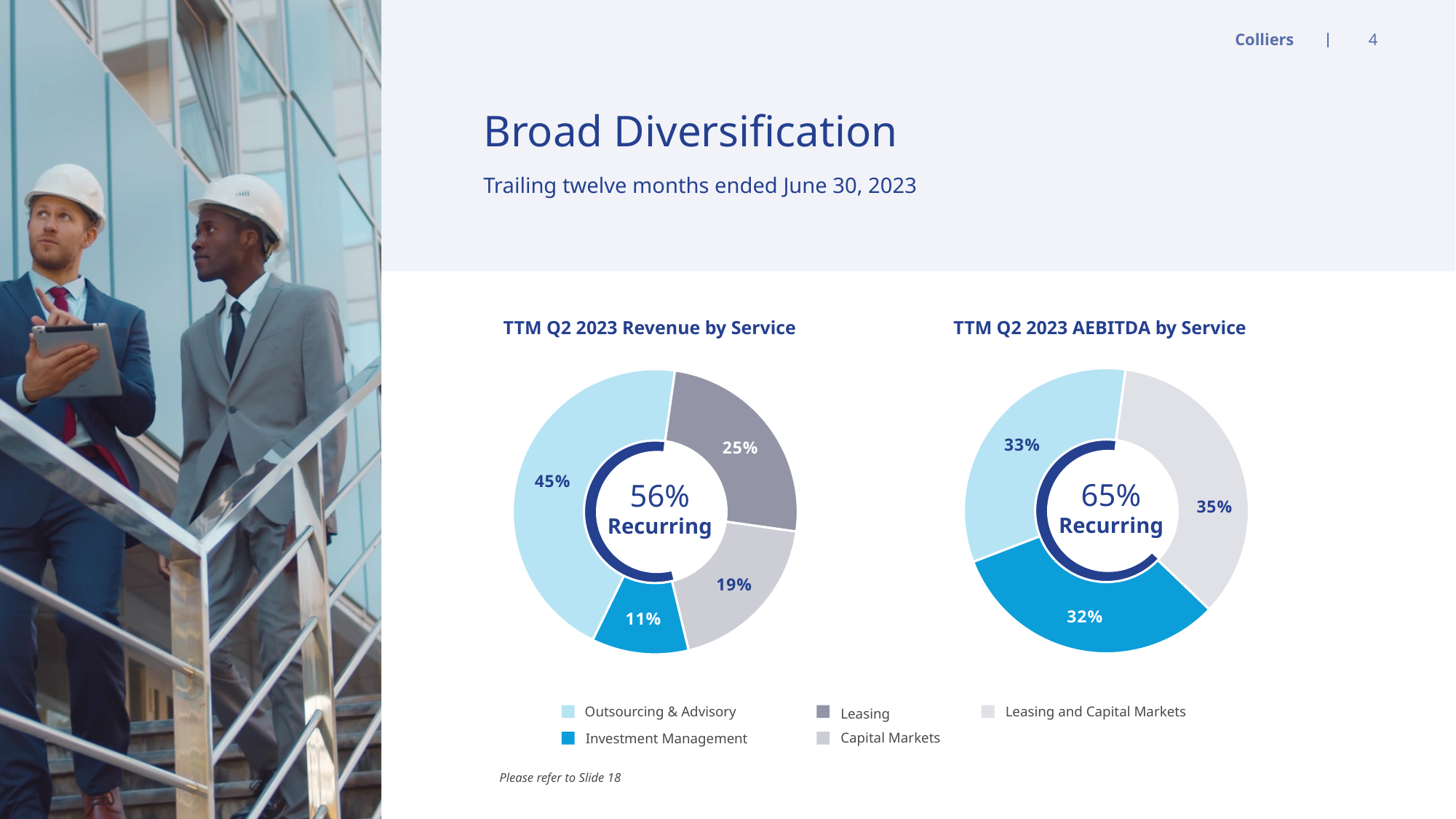
In the TTM Q2 2023 AEBITDA by Service chart, what share comes from Leasing and Capital Markets? 35% What type of chart is the TTM Q2 2023 Revenue by Service chart? Donut (pie) chart In the TTM Q2 2023 Revenue by Service chart, what share of revenue comes from Outsourcing & Advisory? 45% How many segments does the TTM Q2 2023 AEBITDA by Service chart have? 3 In the TTM Q2 2023 Revenue by Service chart, which service has the largest share? Outsourcing & Advisory What recurring percentage is shown in the centre of the TTM Q2 2023 AEBITDA by Service chart? 65% Recurring In the TTM Q2 2023 Revenue by Service chart, what share of revenue comes from Leasing? 25% In the TTM Q2 2023 Revenue by Service chart, what is the difference between the Leasing share and the Capital Markets share? 6% In the TTM Q2 2023 AEBITDA by Service chart, what share comes from Investment Management? 32% In the TTM Q2 2023 Revenue by Service chart, which service has the smallest share? Investment Management In the TTM Q2 2023 AEBITDA by Service chart, which is larger: the Outsourcing & Advisory share or the Investment Management share? Outsourcing & Advisory In the TTM Q2 2023 Revenue by Service chart, what share of revenue comes from Investment Management? 11%